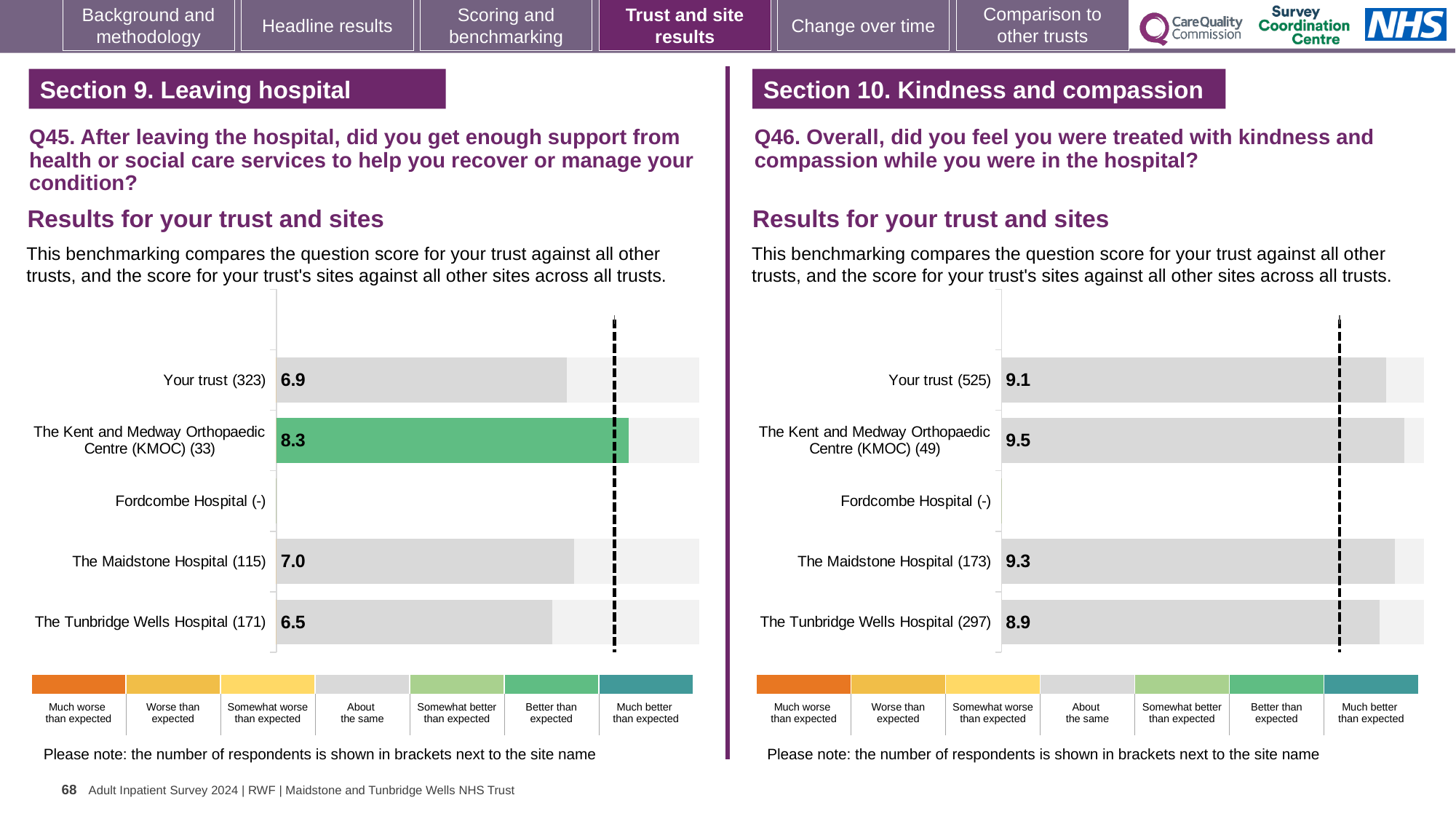
In the Q46 chart (right), how many respondents are shown for Your trust? 525 In the Q46 chart (right), what is the score for The Maidstone Hospital? 9.3 In the Q46 chart (right), what is the score for The Tunbridge Wells Hospital? 8.9 In the Q46 chart (right), which is larger: the score for Your trust or the score for The Maidstone Hospital? The Maidstone Hospital In the Q45 chart (left), which bar is coloured green rather than grey? The Kent and Medway Orthopaedic Centre (KMOC) In the Q45 chart (left), what is the score for Your trust? 6.9 In the Q46 chart (right), which site has the highest score? The Kent and Medway Orthopaedic Centre (KMOC) In the Q45 chart (left), which site has the lowest score? The Tunbridge Wells Hospital In the Q45 chart (left), what is the difference between the scores for The Maidstone Hospital and The Tunbridge Wells Hospital? 0.5 In the Q45 chart (left), what is the score for The Kent and Medway Orthopaedic Centre (KMOC)? 8.3 In the Q46 chart (right), what is the difference between the scores for The Kent and Medway Orthopaedic Centre (KMOC) and Your trust? 0.4 What kind of chart is used in the Q45 chart (left)? Bar chart